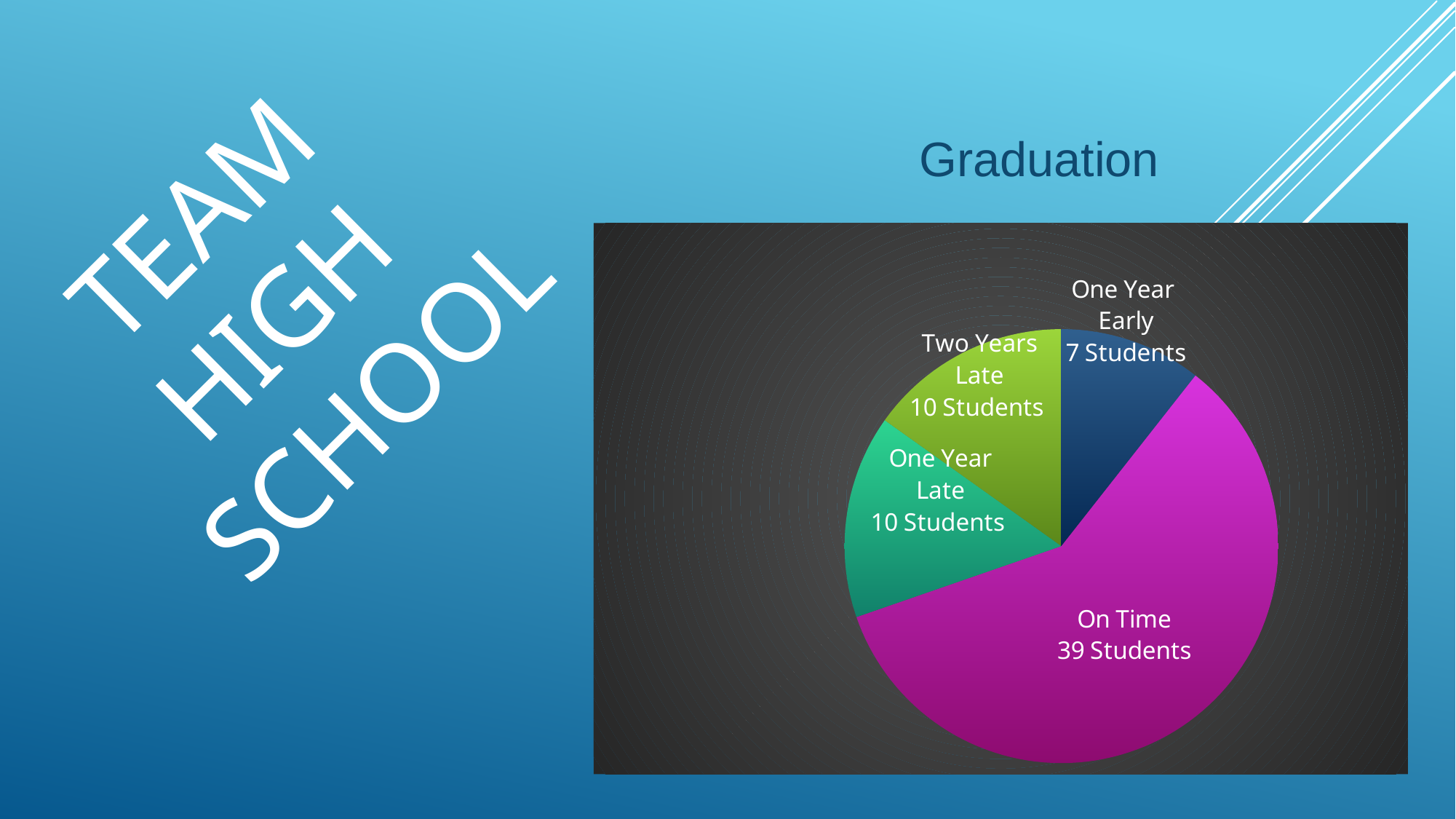
How many more students graduated On Time than One Year Early? 32 How many students graduated Two Years Late? 10 Students Which category has the smallest slice of the pie? One Year Early What is the total number of students represented in the pie chart? 66 How many students graduated On Time? 39 Students How many students graduated One Year Late? 10 Students How many students graduated One Year Early? 7 Students Which category has the largest slice of the pie? On Time What is the title of the chart? Graduation How many categories are shown in the pie chart? 4 Which is larger: the number of students who graduated On Time or One Year Late? On Time What kind of chart is shown on the slide? Pie chart